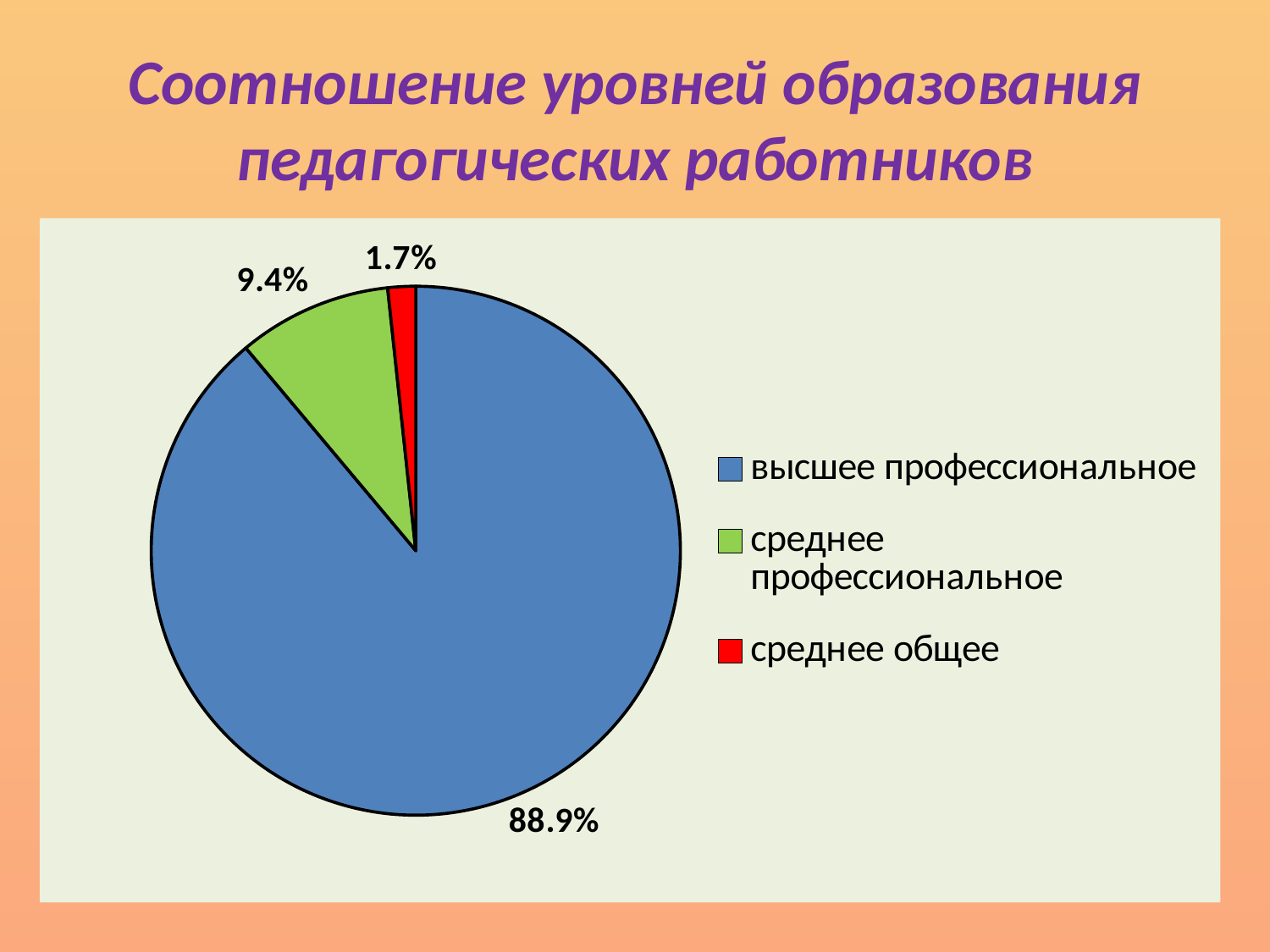
What is the difference between the shares of среднее профессиональное and среднее общее? 7.7% Which category has the largest share of the pie? высшее профессиональное Which category has the smallest share of the pie? среднее общее What is the title of the slide? Соотношение уровней образования педагогических работников What type of chart is shown on the slide? pie chart What is the share for среднее общее? 1.7% Which is larger, the share of среднее профессиональное or среднее общее? среднее профессиональное What is the share for среднее профессиональное? 9.4% What colour is the slice for среднее общее? red How many categories does the pie chart have? 3 What is the difference between the shares of высшее профессиональное and среднее профессиональное? 79.5% What is the share for высшее профессиональное? 88.9%